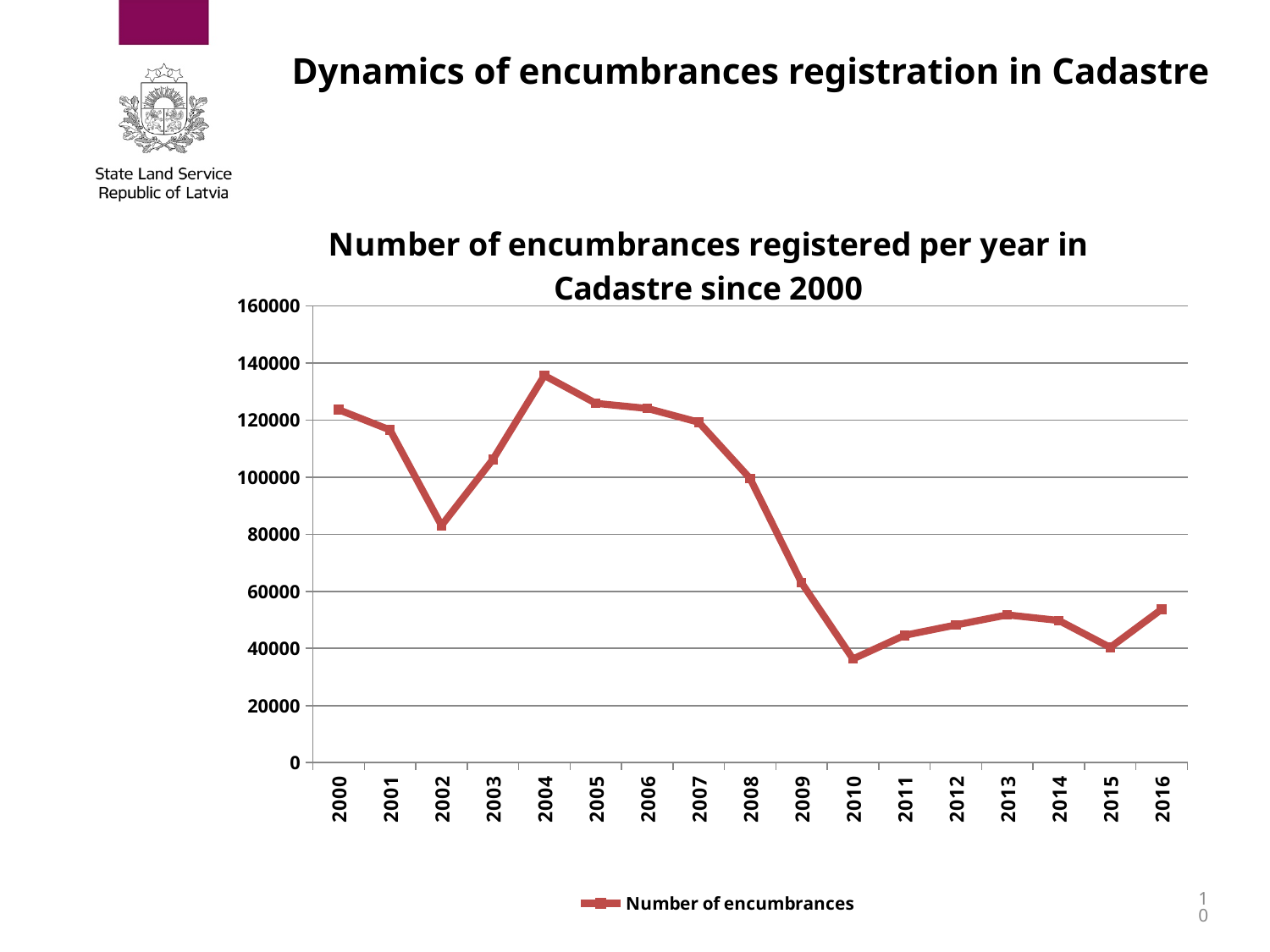
Is the value for 2004 greater or less than 120000? greater Is the value for 2009 greater or less than 60000? greater What is the name of the series shown in the legend? Number of encumbrances How many years are plotted on the x axis? 17 Which year has the lowest number of encumbrances registered? 2010 Is the value for 2010 greater or less than 40000? less What kind of chart is shown on the slide? Line chart How many series does the legend list? 1 Which year has a larger value, 2000 or 2010? 2000 Which year has the highest number of encumbrances registered? 2004 Do the values rise or fall from 2004 to 2010? Fall